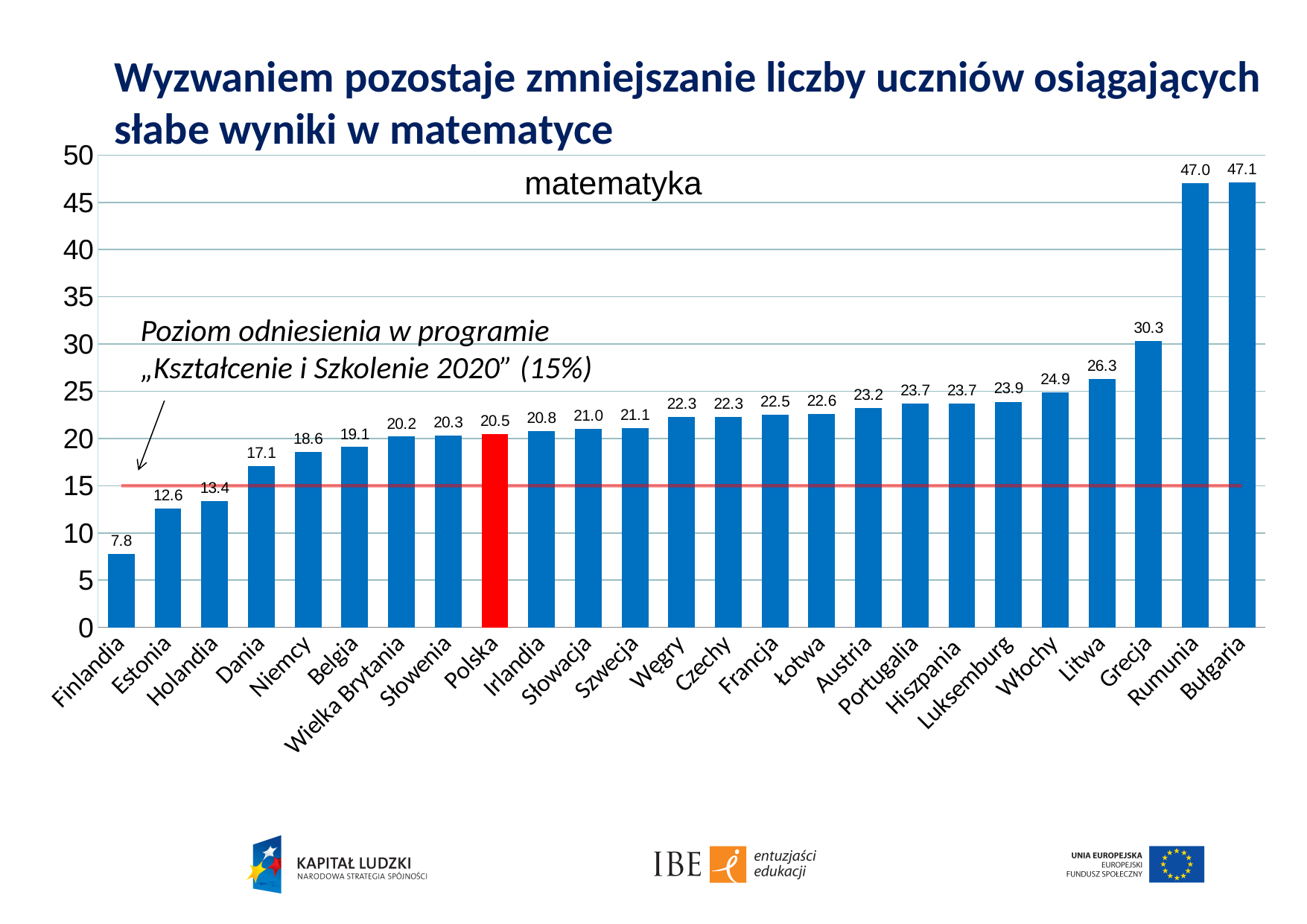
Which bar is coloured red instead of blue? Polska How many countries are shown on the chart? 25 What is the difference between the values for Bułgaria and Polska? 26.6 What is the difference between the values for Dania and Estonia? 4.5 What is the value for Polska? 20.5 What is the value for Grecja? 30.3 Which country has the lowest value? Finlandia What is the value for Niemcy? 18.6 What is the value for Finlandia? 7.8 Which has a larger value, Litwa or Włochy? Litwa Is the value for Holandia greater or less than 15? less What kind of chart is shown on the slide? bar chart